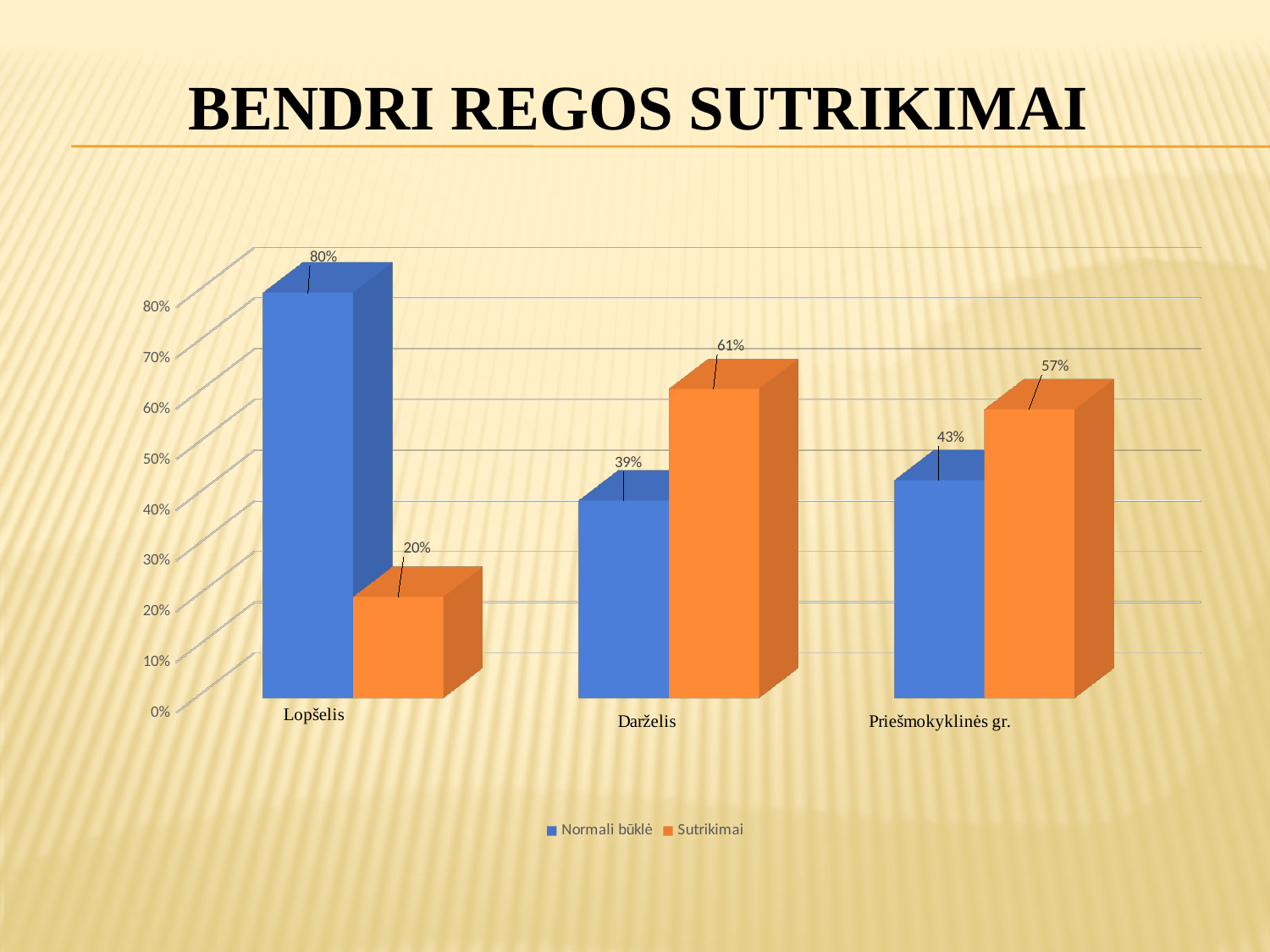
Which category has the highest value for Sutrikimai? Darželis What kind of chart is shown on the slide? Bar chart What is the value for Sutrikimai in the Lopšelis category? 20% How many categories are shown on the x axis? 3 What is the difference between Normali būklė and Sutrikimai in the Lopšelis category? 60% What is the value for Normali būklė in the Lopšelis category? 80% How many series does the legend list? 2 Which category has the lowest value for Normali būklė? Darželis In the Priešmokyklinės gr. category, which is larger: Normali būklė or Sutrikimai? Sutrikimai What is the value for Sutrikimai in the Darželis category? 61% What is the title of the slide? BENDRI REGOS SUTRIKIMAI What is the value for Normali būklė in the Priešmokyklinės gr. category? 43%